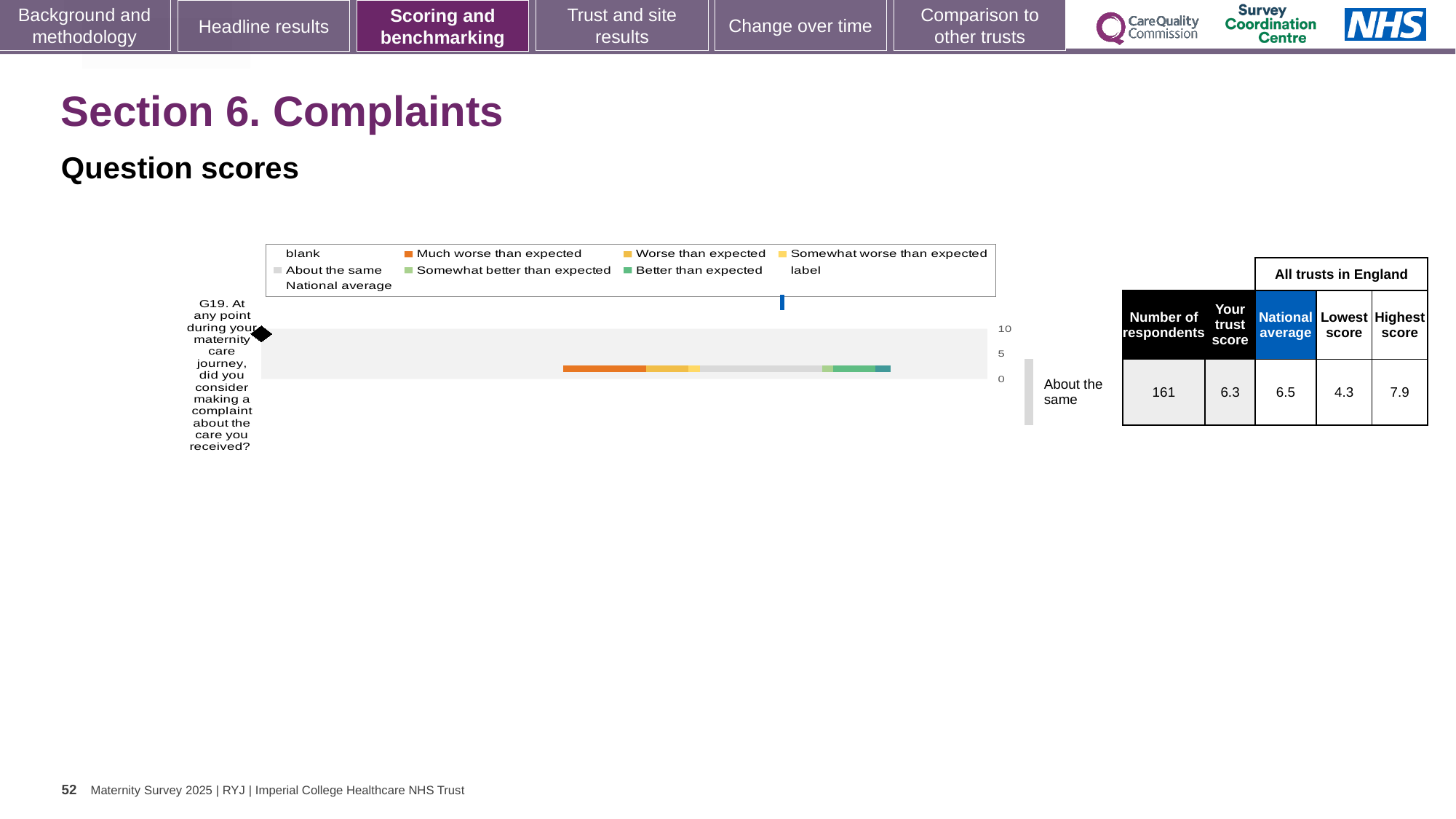
What is the highest value shown on the chart's score axis? 10 According to the table beside the chart, what is the national average for G19? 6.5 What is the difference between the highest score (7.9) and the lowest score (4.3) for G19? 3.6 What is the difference between the national average and the trust score for G19? 0.2 Which benchmark category is the trust's G19 result placed in? About the same What kind of chart is shown on the slide? Bar chart According to the table beside the chart, how many respondents answered G19? 161 Which question number is plotted in the chart? G19 According to the table beside the chart, what is the trust score for G19? 6.3 What colour does the legend use for 'Much worse than expected'? Orange How many survey questions are plotted in the chart? 1 Which is larger for G19, the trust score or the national average? National average